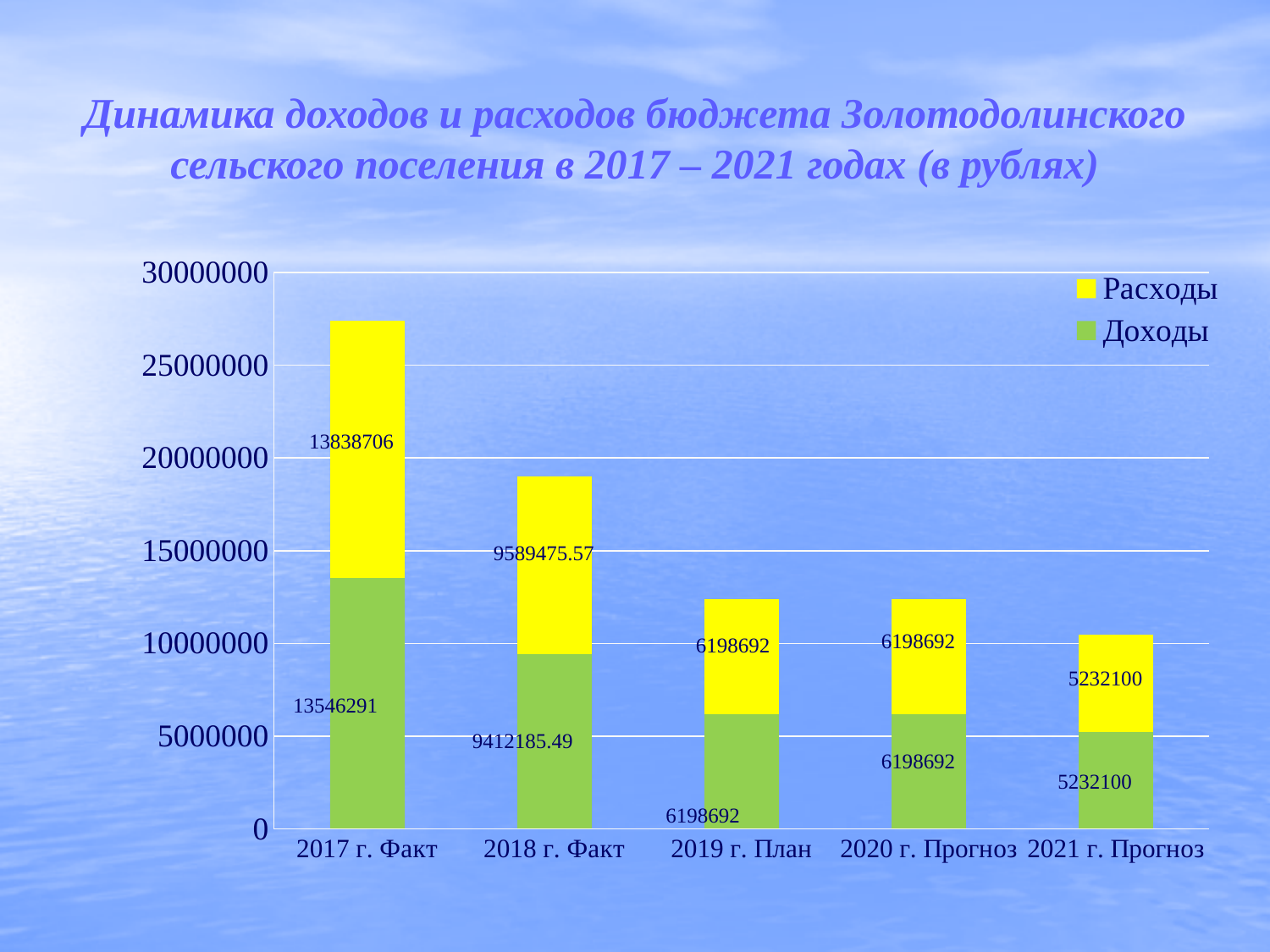
Is the total of the stacked bar for 2017 г. Факт greater or less than 25000000? greater What type of chart is shown on the slide? stacked bar chart What is the value of Расходы for 2018 г. Факт? 9589475.57 Which category has the highest value of Доходы? 2017 г. Факт What is the value of Расходы for 2021 г. Прогноз? 5232100 How many categories are shown on the x axis? 5 Which colour represents Расходы in the chart? yellow Which category has the lowest value of Расходы? 2021 г. Прогноз What is the total of the stacked bar for 2020 г. Прогноз? 12397384 What is the difference between Расходы and Доходы for 2017 г. Факт? 292415 What is the value of Доходы for 2017 г. Факт? 13546291 How many series does the legend list? 2